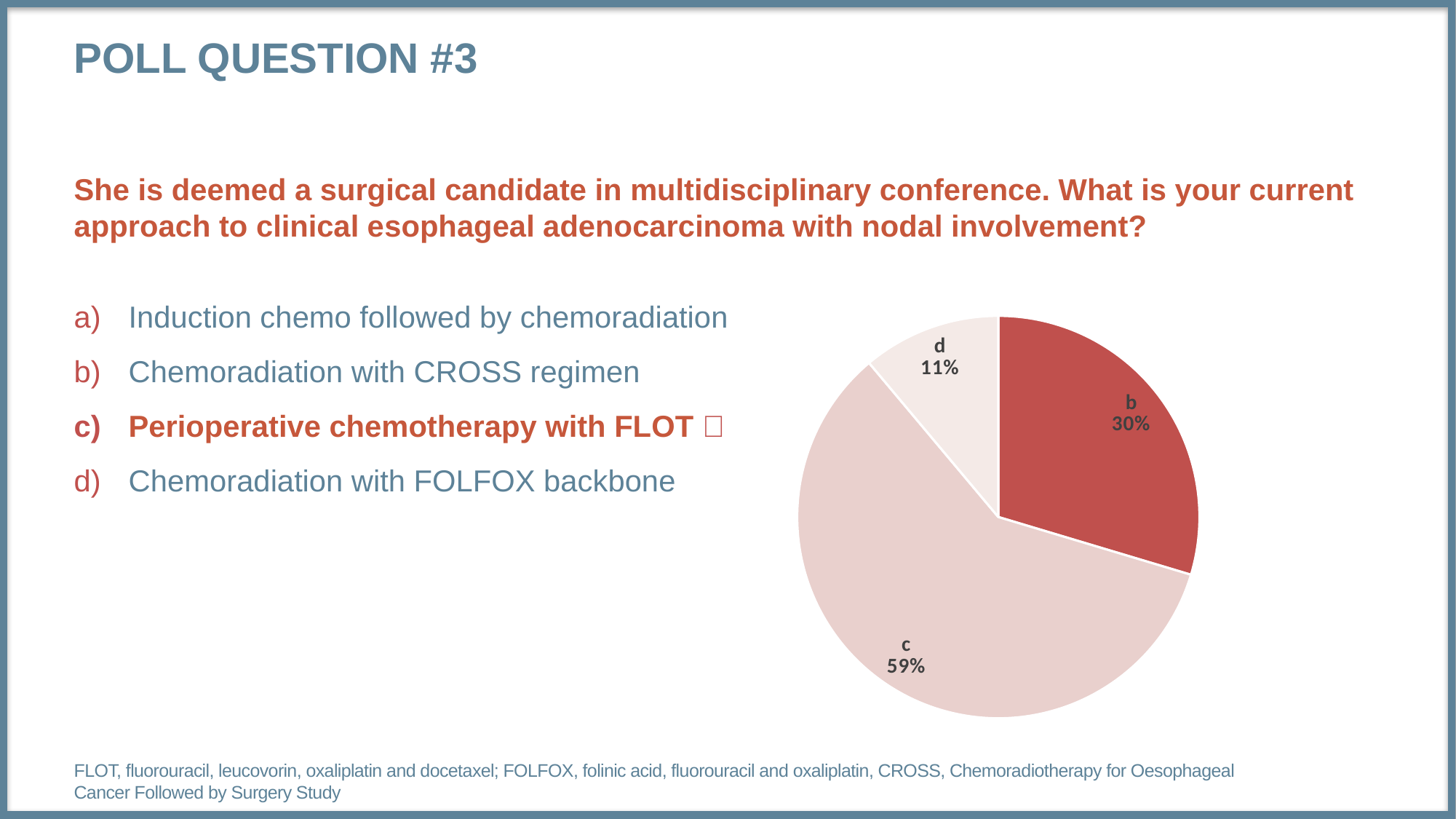
Which slice is larger, b or d? b What share of the pie does slice c represent? 59% How many slices does the pie chart have? 3 What percentage of the pie chart is labelled d? 11% Which slice of the pie chart is the smallest? d Which slice of the pie chart is the largest? c What is the difference in percentage points between slice c and slice b? 29 What kind of chart is shown on the slide? pie chart What percentage of the pie chart is labelled b? 30% What percentage of the pie chart is labelled c? 59% Which slice of the pie chart is coloured the darkest red? b What is the difference in percentage points between slice b and slice d? 19